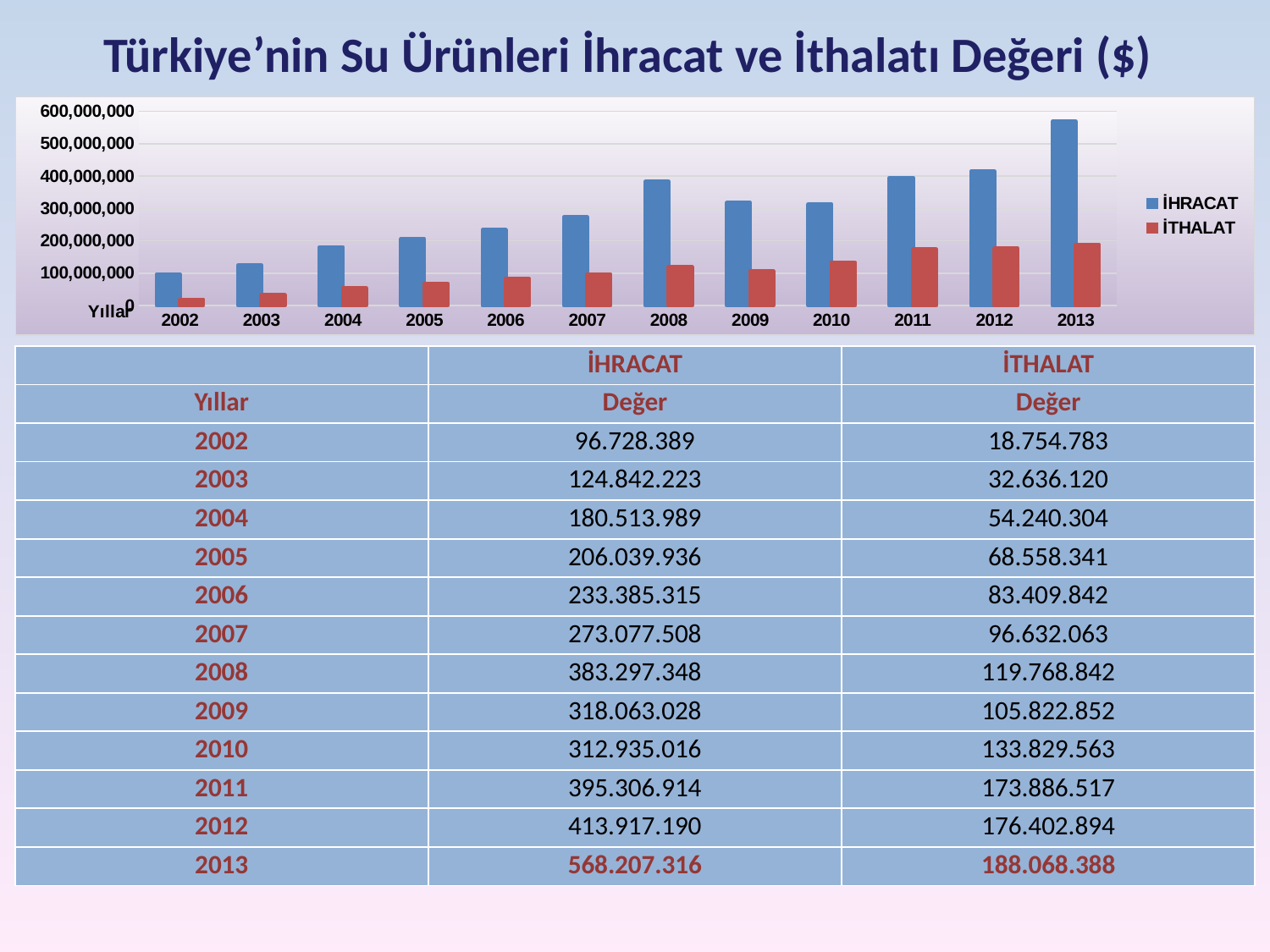
How many years are shown on the x axis of the chart? 12 Is the İHRACAT value for 2012 greater or less than 400,000,000? greater How many series does the chart legend list? 2 Does the İTHALAT series generally rise or fall from 2002 to 2013? rise Which year has the highest İHRACAT value? 2013 Is the İTHALAT value for 2013 greater or less than 200,000,000? less Which year has the lowest İTHALAT value? 2002 What is the İHRACAT value for 2013? 568.207.316 What kind of chart is shown on the slide? bar chart Which is larger, the İHRACAT value for 2008 or the İHRACAT value for 2009? 2008 What is the İTHALAT value for 2008? 119.768.842 What is the difference between the İHRACAT and İTHALAT values for 2013? 380.138.928